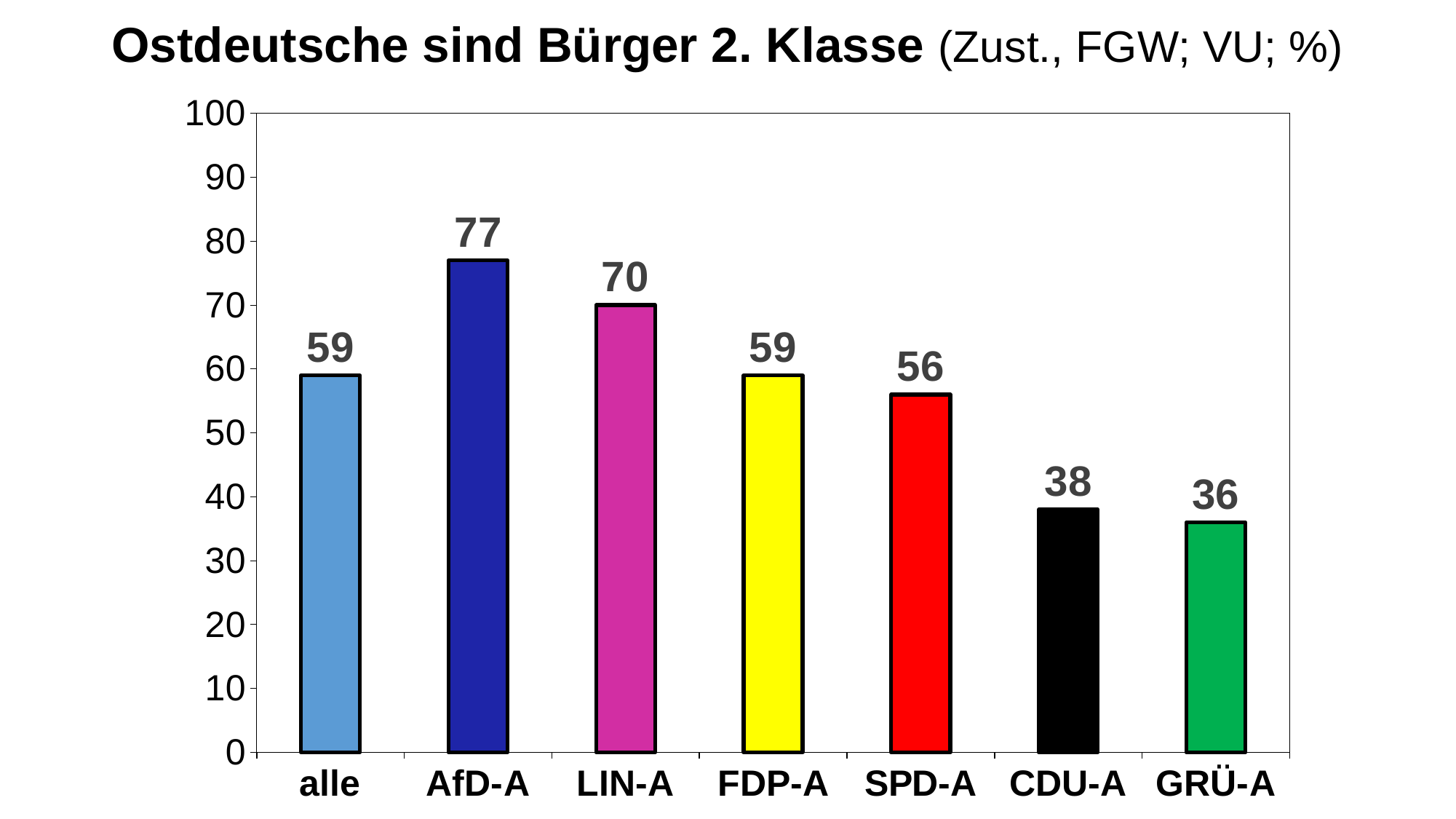
What is the difference between the values for AfD-A and GRÜ-A? 41 How many categories are shown on the x axis? 7 What is the value for AfD-A? 77 Which is larger, the value for LIN-A or the value for FDP-A? LIN-A What is the value for CDU-A? 38 What is the value for SPD-A? 56 What colour is the bar for FDP-A? yellow Which category has the highest value? AfD-A What kind of chart is shown on the slide? bar chart Which category has the lowest value? GRÜ-A Is the value for CDU-A greater or less than 40? less What is the difference between the values for LIN-A and SPD-A? 14